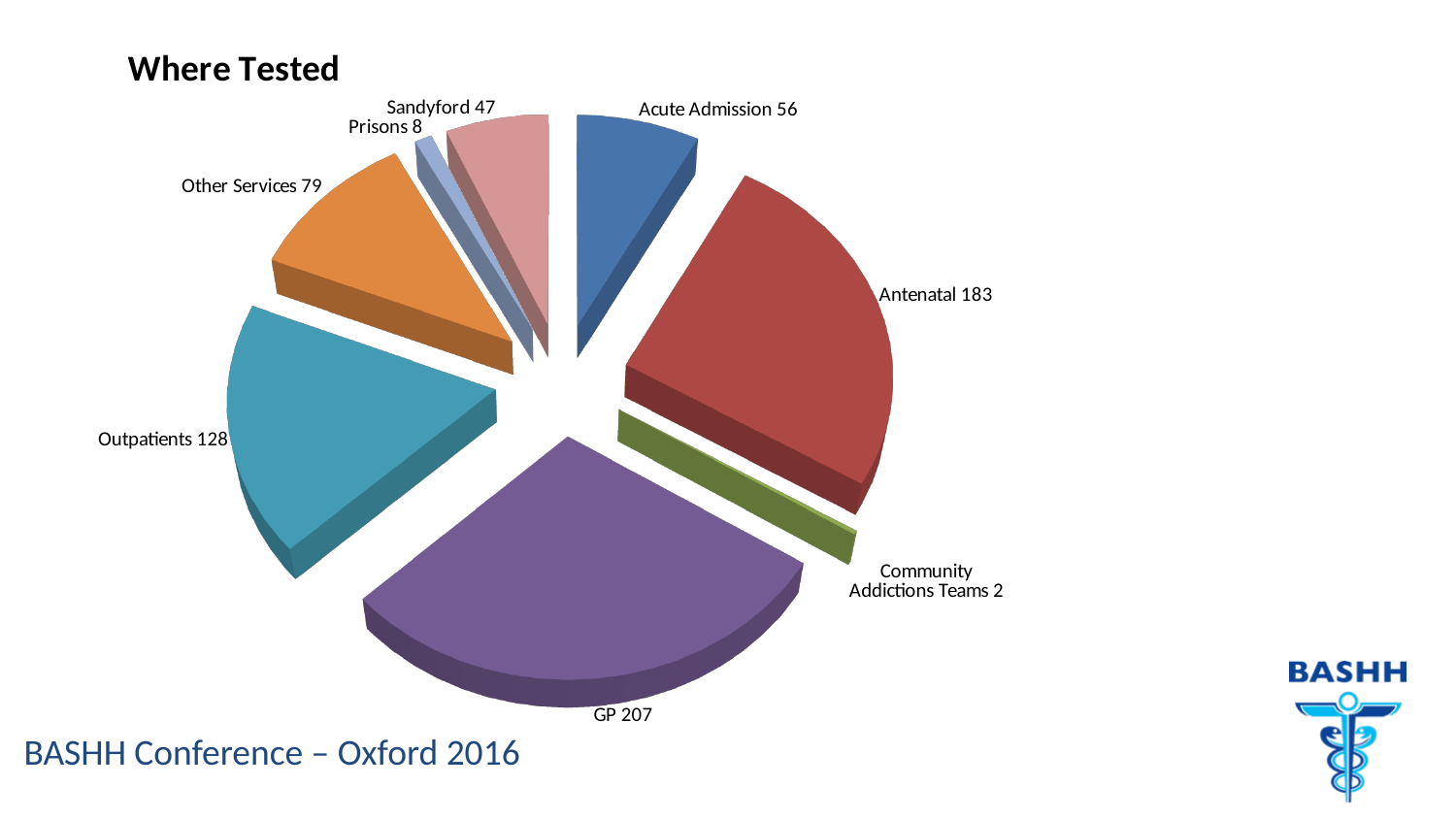
What is the value for Outpatients? 128 What type of chart is shown on the slide? Pie chart How many categories does the pie chart show? 8 What is the value for Sandyford? 47 Which category has the lowest value? Community Addictions Teams Which category has the highest value? GP What is the value for GP? 207 What is the difference between the values for Acute Admission and Prisons? 48 What is the title of the chart? Where Tested What is the value for Antenatal? 183 Which is larger, the value for Outpatients or the value for Other Services? Outpatients What is the difference between the values for GP and Antenatal? 24